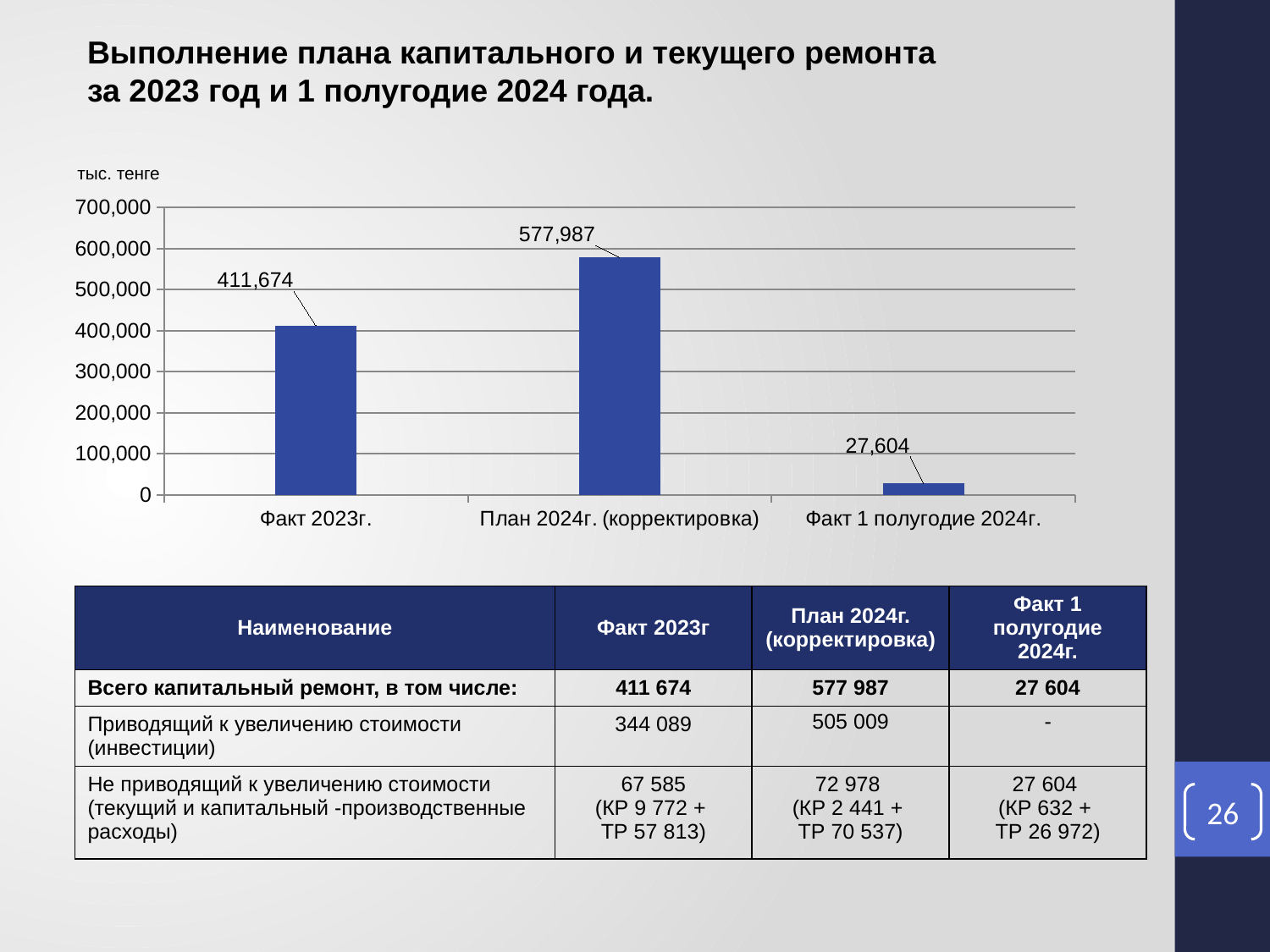
Which category has the highest value in the chart? План 2024г. (корректировка) What kind of chart is shown on the slide? bar chart What unit is indicated above the chart's vertical axis? тыс. тенге Is the value for Факт 2023г. greater or less than 400,000? greater What is the difference between the values for Факт 2023г. and Факт 1 полугодие 2024г.? 384,070 Which category has the lowest value in the chart? Факт 1 полугодие 2024г. What is the value for План 2024г. (корректировка) in the chart? 577,987 How many categories are shown in the chart? 3 What is the value for Факт 2023г. in the chart? 411,674 What is the value for Факт 1 полугодие 2024г. in the chart? 27,604 Which is larger: the value for Факт 2023г. or the value for План 2024г. (корректировка)? План 2024г. (корректировка) What is the difference between the values for План 2024г. (корректировка) and Факт 2023г.? 166,313